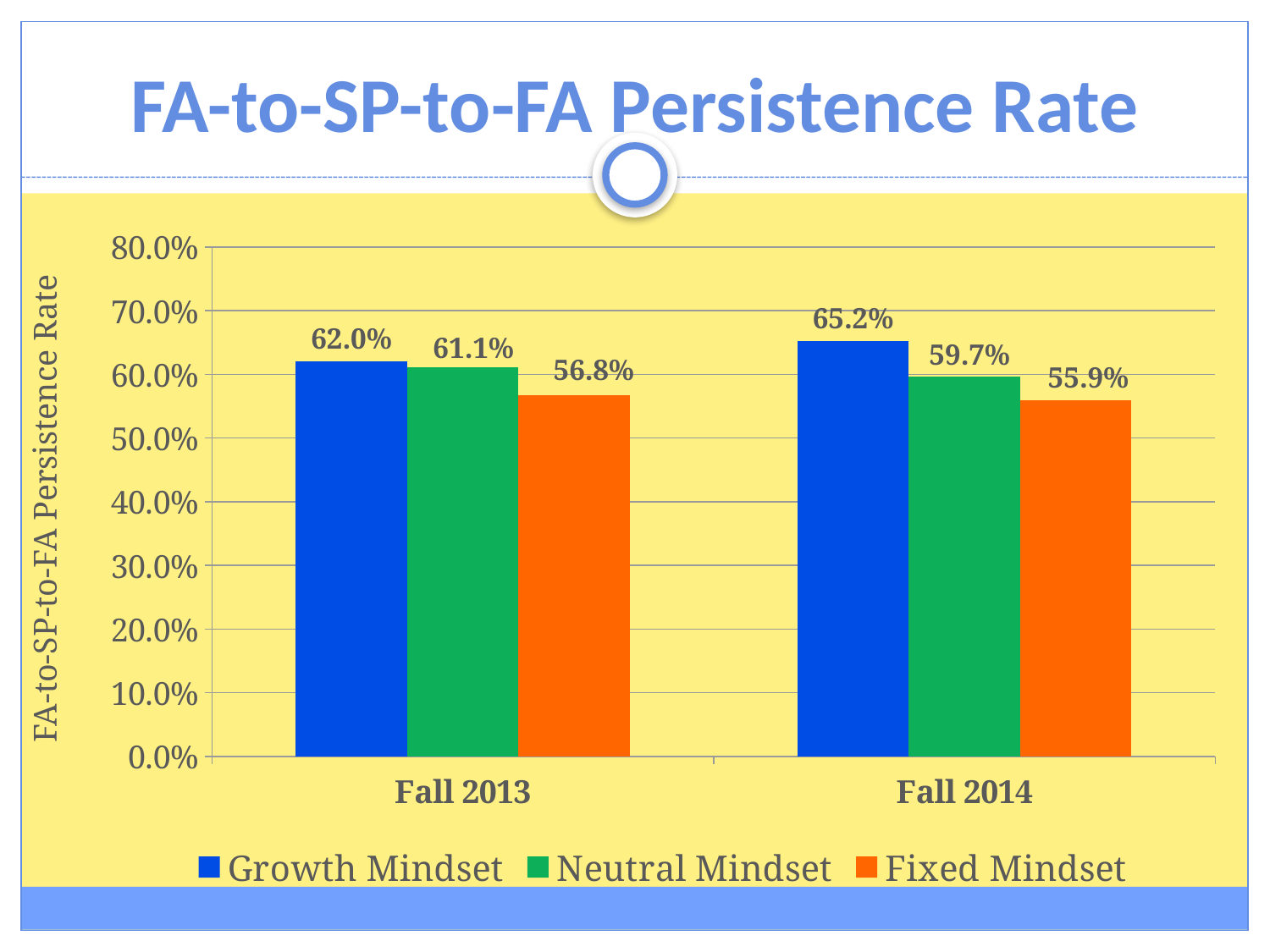
What is the difference between the Growth Mindset and Fixed Mindset persistence rates in Fall 2014? 9.3% What is the persistence rate for Fixed Mindset in Fall 2014? 55.9% What is the FA-to-SP-to-FA persistence rate for Growth Mindset in Fall 2013? 62.0% Which mindset group has the highest persistence rate in Fall 2014? Growth Mindset How many categories are shown on the x axis? 2 What is the persistence rate for Neutral Mindset in Fall 2014? 59.7% What kind of chart is shown on the slide? Bar chart Which colour represents Fixed Mindset in the chart? Orange Which is larger: the Neutral Mindset rate in Fall 2013 or the Neutral Mindset rate in Fall 2014? Fall 2013 Which mindset group has the lowest persistence rate in Fall 2013? Fixed Mindset How many series does the legend list? 3 What is the difference between the Growth Mindset persistence rate in Fall 2014 and in Fall 2013? 3.2%